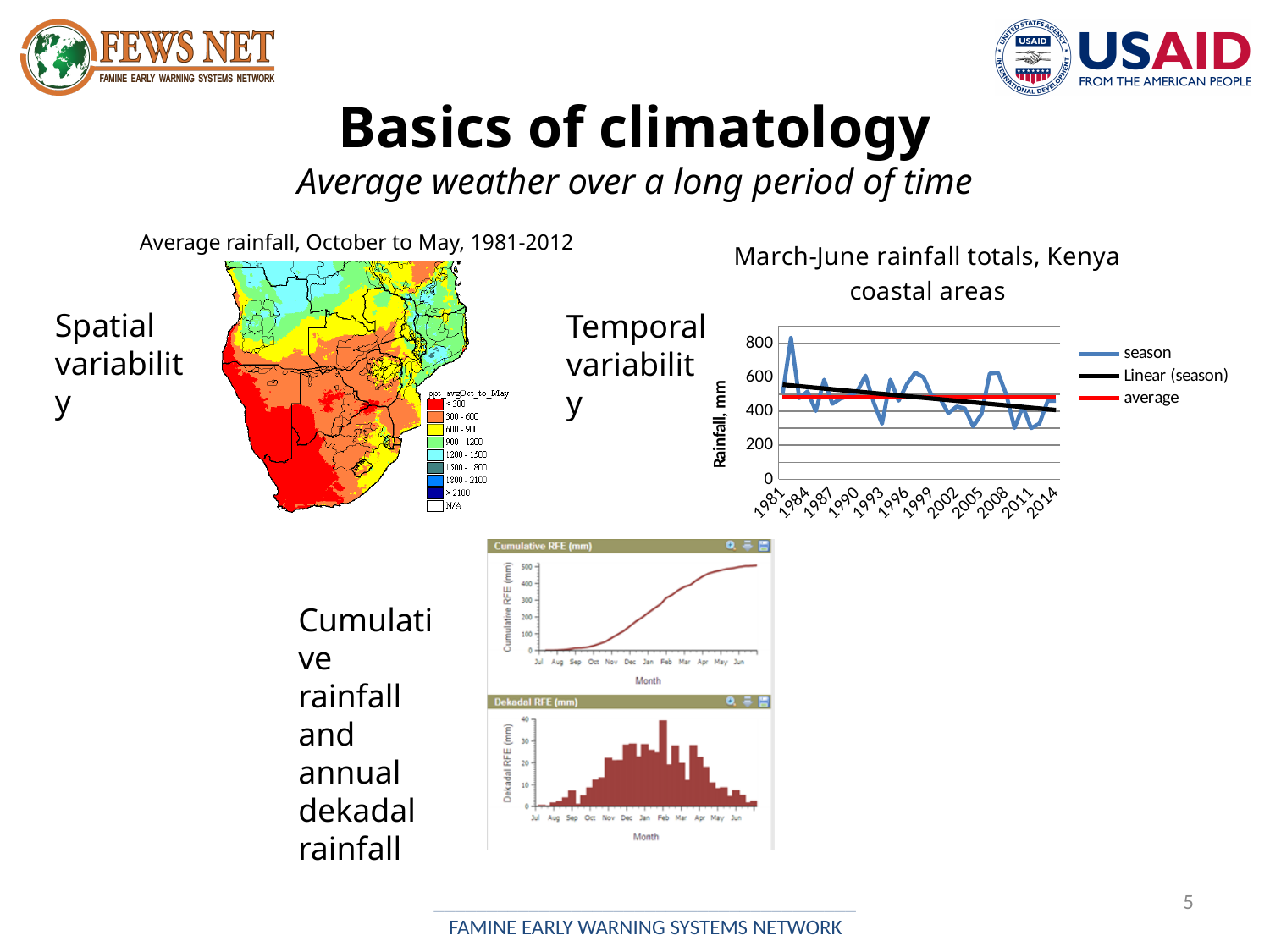
What type of chart is the 'March-June rainfall totals, Kenya coastal areas' chart? line chart What is the y-axis label of the 'March-June rainfall totals, Kenya coastal areas' chart? Rainfall, mm How many months are labelled on the x axis of the 'Dekadal RFE (mm)' chart? 12 In the 'March-June rainfall totals, Kenya coastal areas' chart, does the Linear (season) trend line rise or fall from 1981 to 2014? fall In the 'March-June rainfall totals, Kenya coastal areas' chart, is the peak value of the season series greater or less than 600? greater In the 'Cumulative RFE (mm)' chart, do the values rise or fall from Jul to Jun? rise How many series does the legend of the 'March-June rainfall totals, Kenya coastal areas' chart list? 3 What type of chart is the 'Dekadal RFE (mm)' chart at the bottom of the slide? bar chart In the 'March-June rainfall totals, Kenya coastal areas' chart, is the average line greater or less than 400? greater In the 'March-June rainfall totals, Kenya coastal areas' chart, is the average line greater or less than 600? less What are the legend entries of the 'March-June rainfall totals, Kenya coastal areas' chart? season, Linear (season), average What type of chart is the 'Cumulative RFE (mm)' chart? line chart